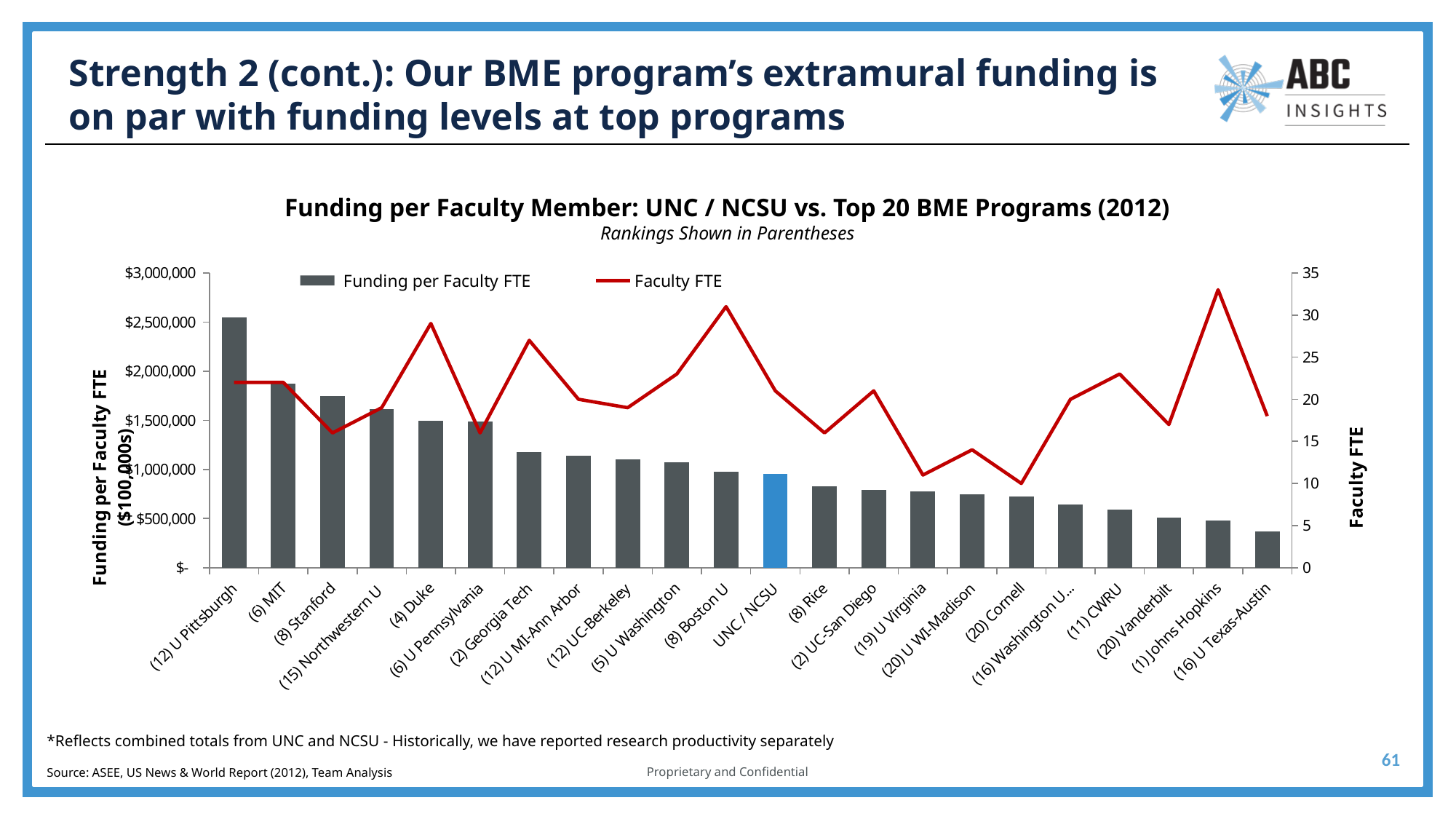
What kind of chart is shown on the slide? A combined bar and line chart Is the Faculty FTE for (1) Johns Hopkins greater or less than 30? greater Which program has the highest Faculty FTE value on the line? (1) Johns Hopkins Which program has the highest Funding per Faculty FTE bar? (12) U Pittsburgh Is the Funding per Faculty FTE for (12) U Pittsburgh greater or less than $2,000,000? greater How many series does the legend list? 2 Is the Funding per Faculty FTE for UNC / NCSU greater or less than $1,000,000? less Which program has the lowest Funding per Faculty FTE bar? (16) U Texas-Austin Do the Funding per Faculty FTE bars generally rise or fall from left to right? fall Which has the higher Funding per Faculty FTE bar, (6) MIT or (8) Stanford? (6) MIT How many programs are shown along the x axis? 22